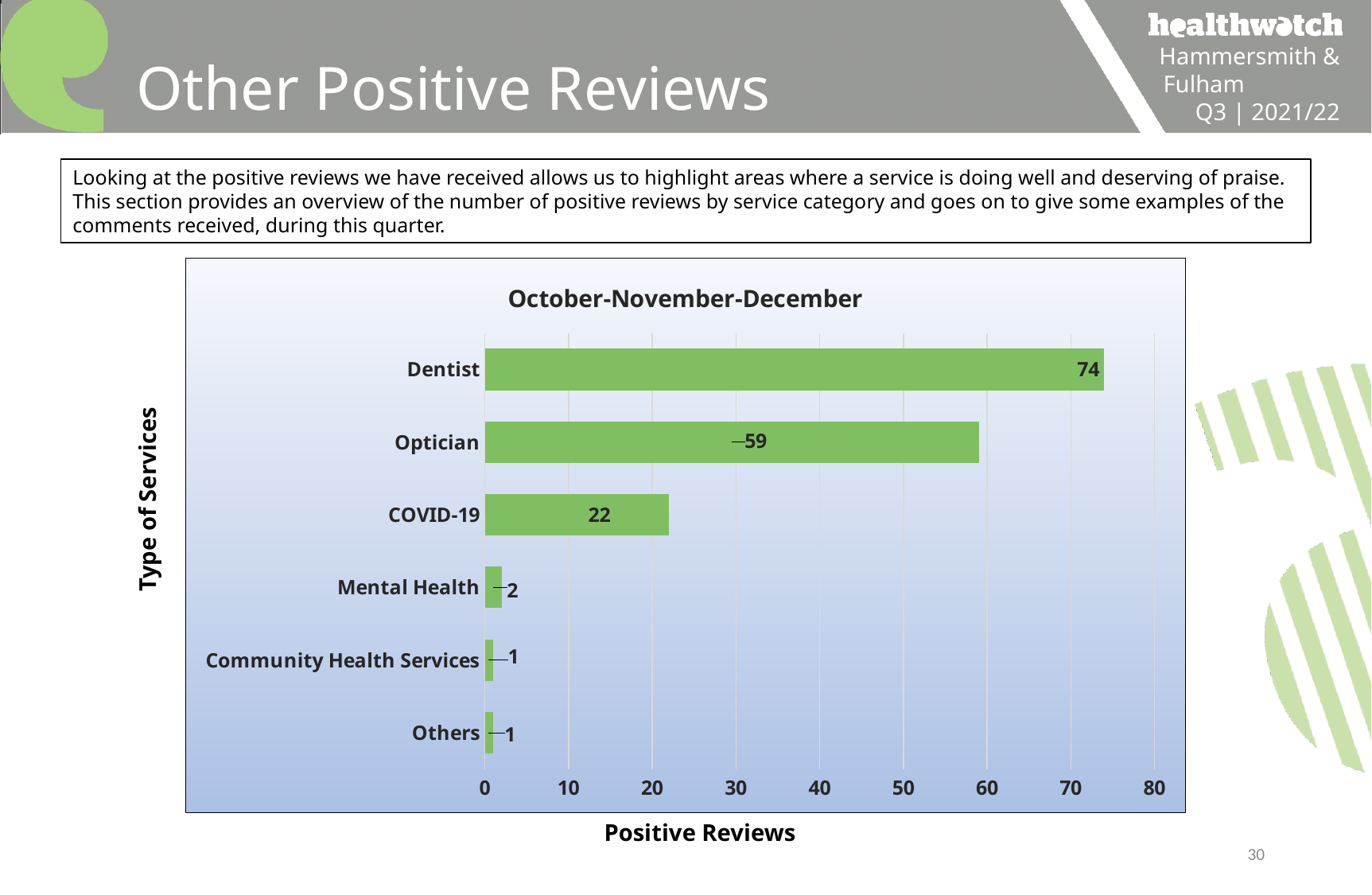
What kind of chart is shown on the slide? Bar chart What is the title of the chart? October-November-December What is the difference between the Optician and COVID-19 values? 37 What is the value for Mental Health? 2 How many positive reviews did Dentist receive? 74 Is the value for Dentist greater or less than 70? greater What is the difference between the Dentist and Optician values? 15 Which type of service has the highest number of positive reviews? Dentist Which has more positive reviews, COVID-19 or Mental Health? COVID-19 How many types of services are shown in the chart? 6 What is the value for Optician? 59 How many positive reviews are shown for COVID-19? 22